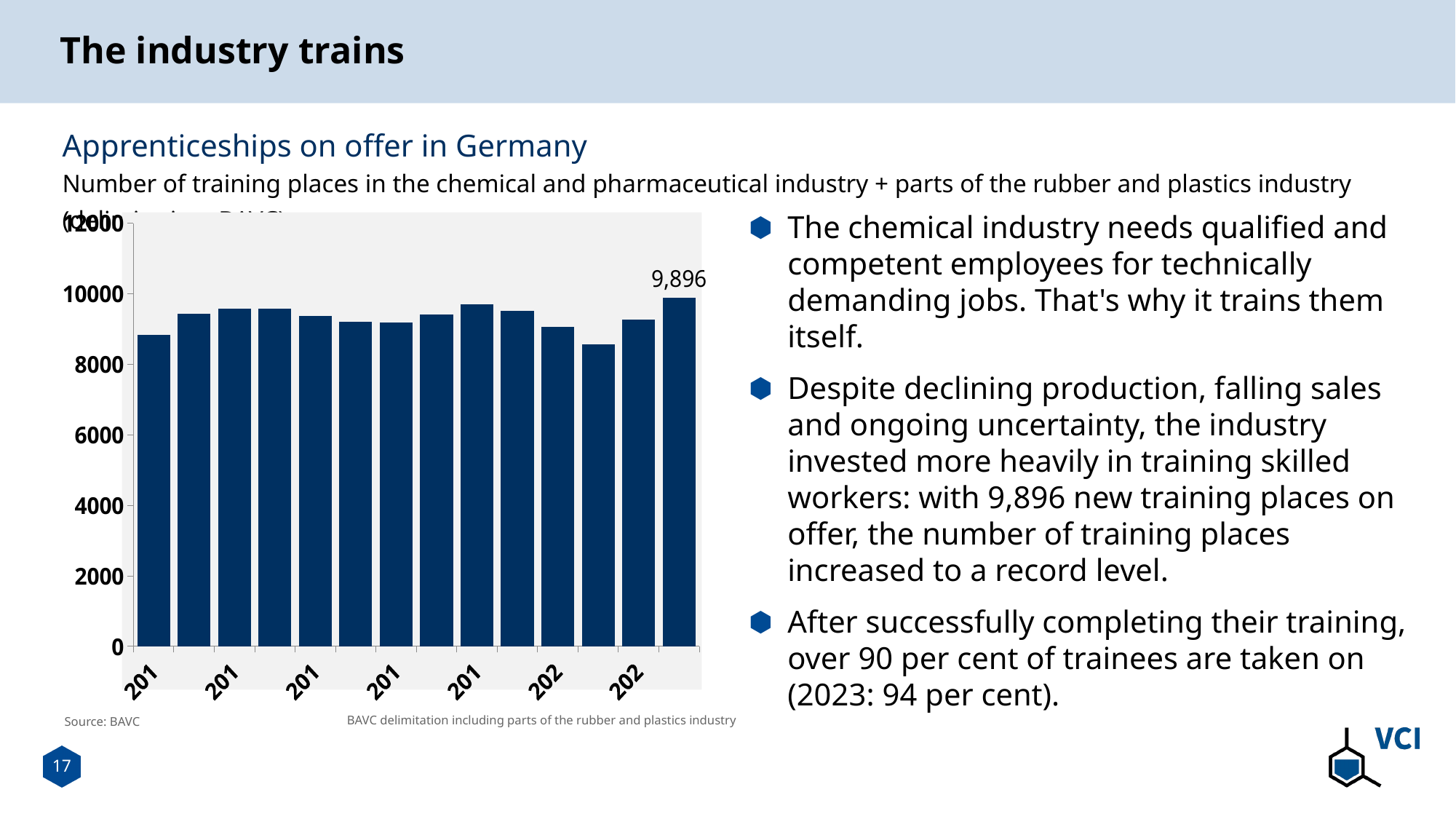
Is the value of the first (leftmost) bar greater or less than 10000? less What is the title of the chart? Apprenticeships on offer in Germany Which is larger, the rightmost bar or the bar immediately to its left? the rightmost bar What kind of chart is shown on the slide? bar chart What source is cited for the chart? BAVC Which is larger, the leftmost bar or the rightmost bar? the rightmost bar Is the value of the rightmost bar greater or less than 8000? greater What value is labelled on the rightmost bar of the chart? 9,896 Which bar in the chart is the highest? the rightmost (last) bar Is the value of the lowest bar greater or less than 6000? greater Which bar in the chart is the lowest? the third bar from the right How many bars are plotted in the chart? 14